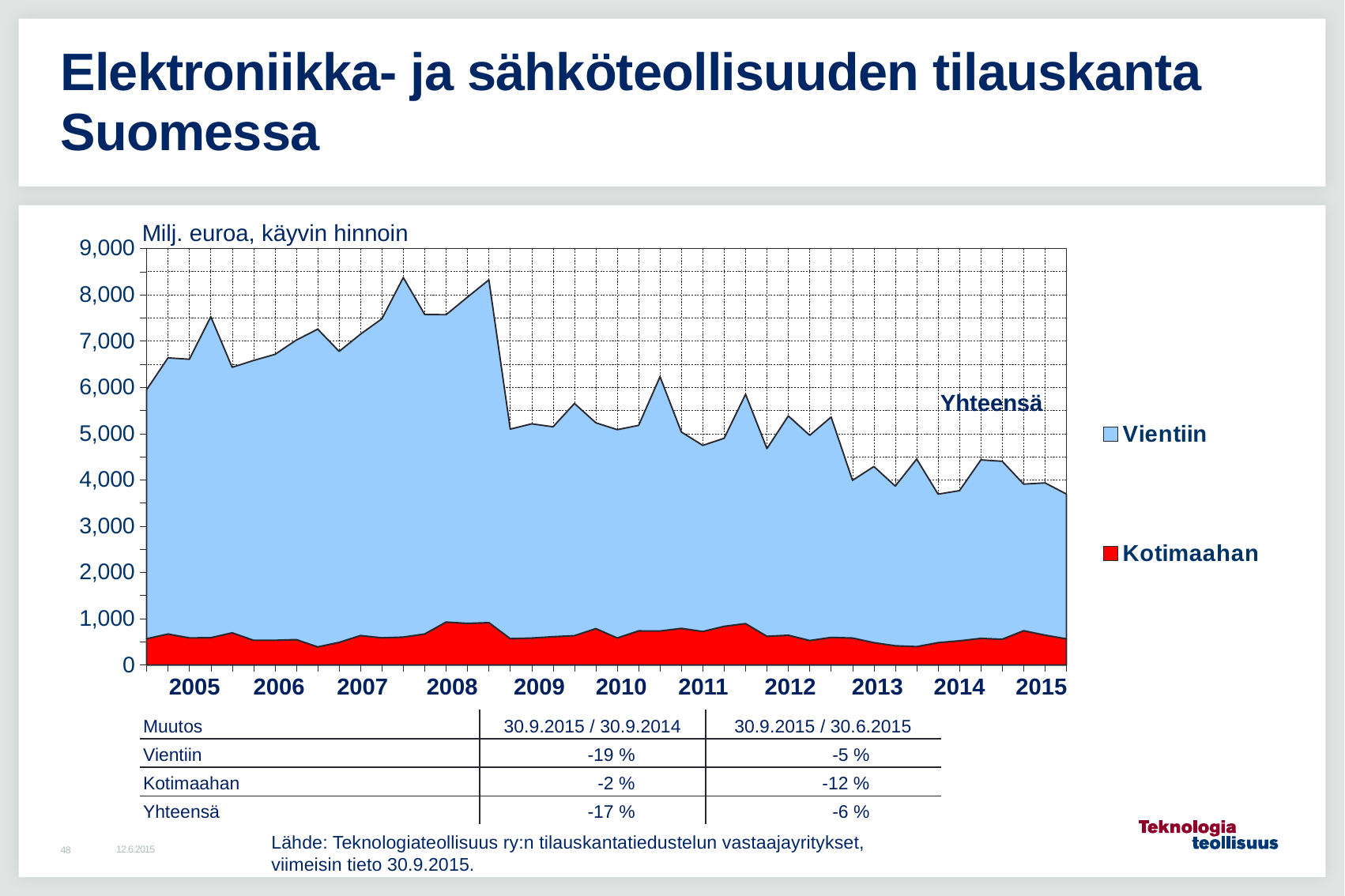
Is the total (Yhteensä) value at the start of 2005 greater or less than 5,000? greater What unit label is shown above the chart's y axis? Milj. euroa, käyvin hinnoin How many series does the legend list? 2 In which year does the total (Yhteensä) reach its highest point? 2007 Which series is larger throughout the chart, Vientiin or Kotimaahan? Vientiin Which two series are listed in the legend? Vientiin and Kotimaahan What kind of chart is shown on the slide? area chart Is the peak total (Yhteensä) value in 2008 greater or less than 8,000? greater Is the Kotimaahan value at any point greater or less than 1,000? less How many years are labelled on the x axis? 11 Does the total (Yhteensä) overall rise or fall from 2005 to 2015? fall